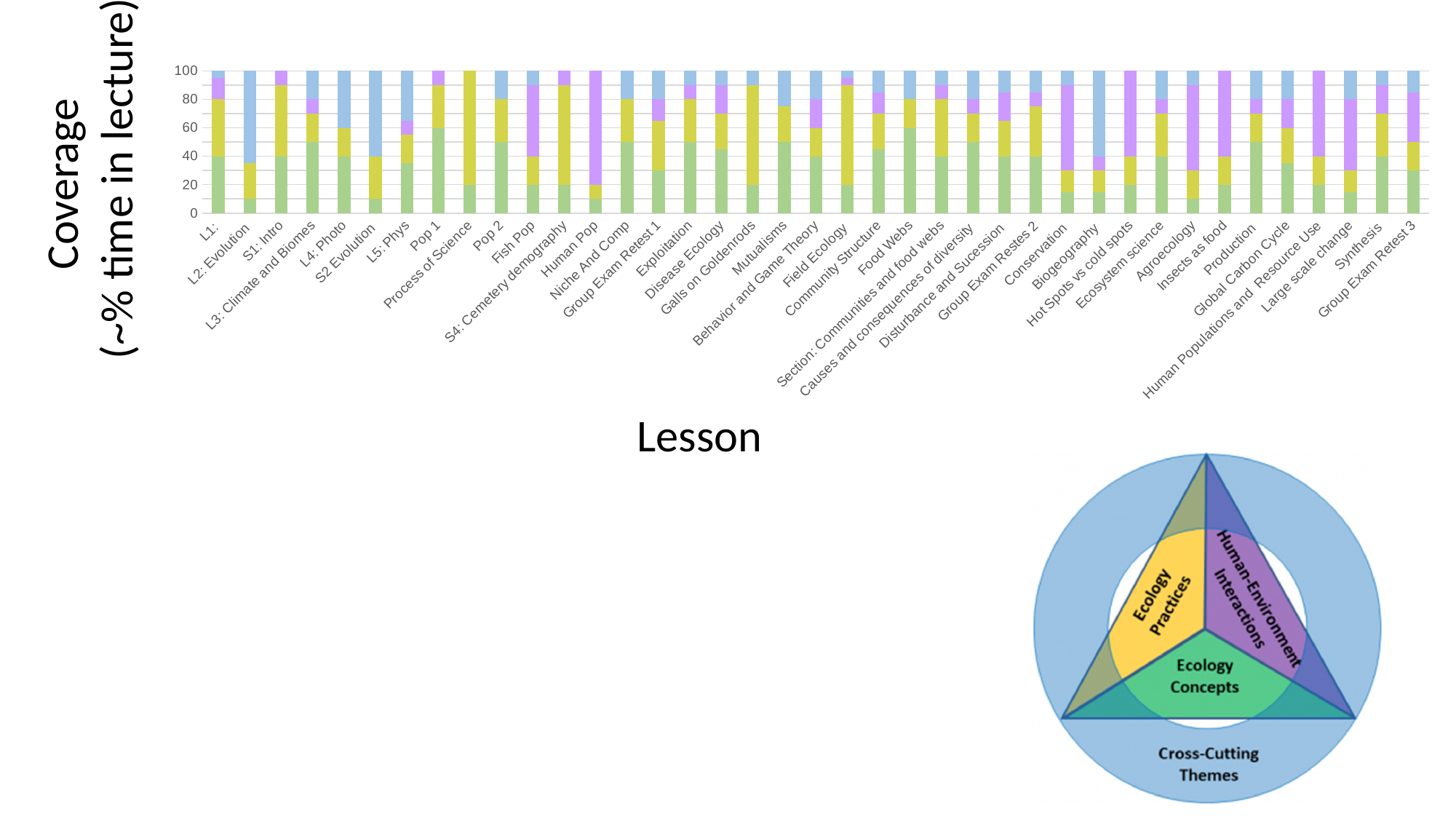
What is the total height of the L2: Evolution stacked bar? 100 What is the title of the x axis of the chart? Lesson Is the green segment for Agroecology greater or less than 20? less What is the title of the y axis of the chart? Coverage (~% time in lecture) What kind of chart is shown on the slide? stacked bar chart What is the highest value shown on the y axis? 100 Is the green segment for Process of Science greater or less than 40? less Which has the larger green segment, Food Webs or Agroecology? Food Webs Is the purple segment for Human Pop greater or less than 60? greater How many lessons (bars) are plotted on the x axis? 39